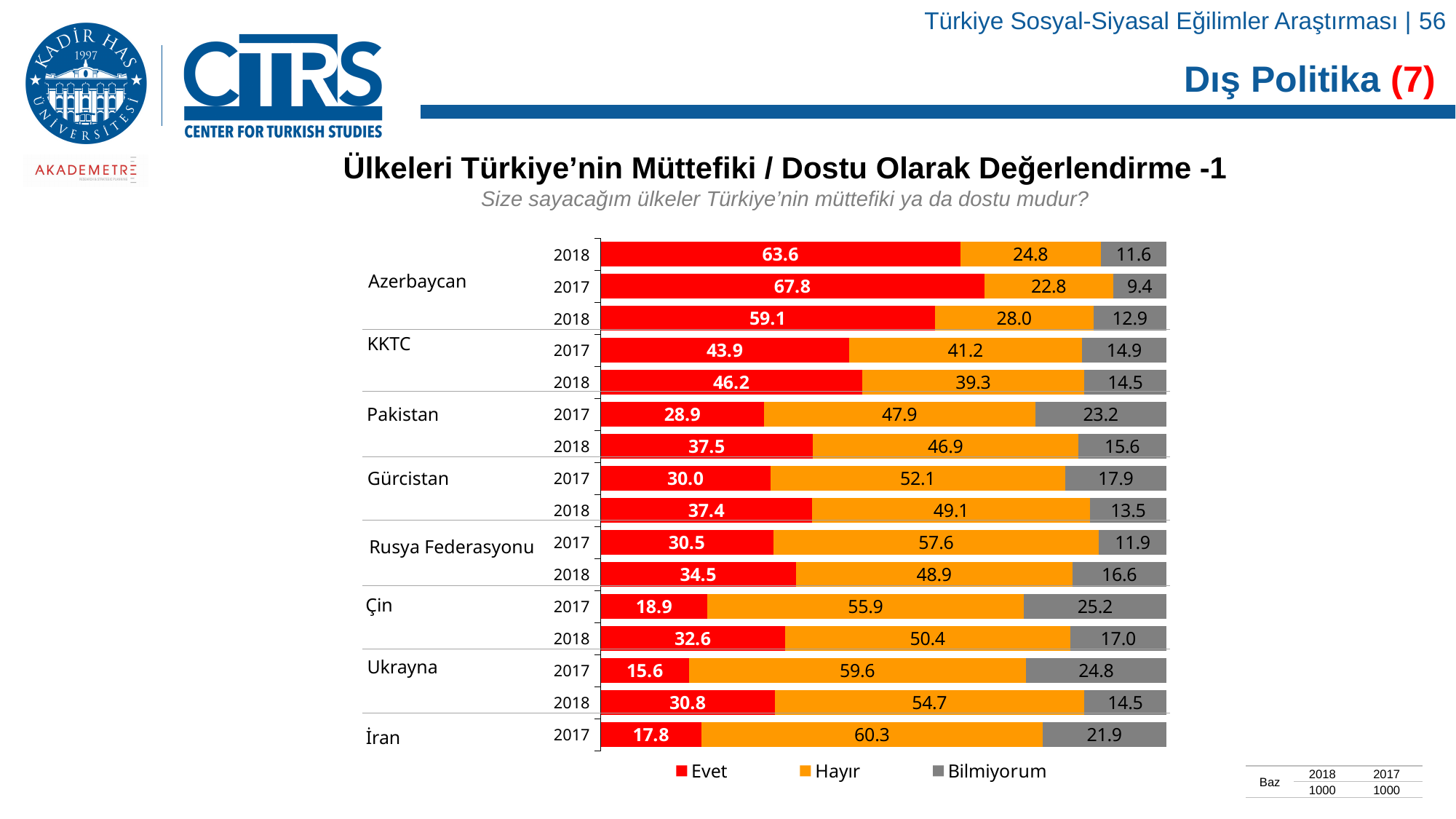
What is the Evet value for Azerbaycan in 2018? 63.6 What is the Evet value for İran in 2018? 30.8 How many bars are shown in the chart? 16 Which country and year has the lowest Evet value? Ukrayna 2017 What is the Hayır value for Rusya Federasyonu in 2017? 57.6 What is the difference between the Evet values for KKTC in 2018 and 2017? 15.2 What is the Bilmiyorum value for Çin in 2017? 25.2 Which is larger, the Hayır value for Pakistan in 2017 or for Gürcistan in 2017? Gürcistan 2017 What are the three legend entries of the chart? Evet, Hayır, Bilmiyorum Which country and year has the highest Evet value? Azerbaycan 2017 What kind of chart is shown on the slide? Stacked bar chart How many series does the legend list? 3